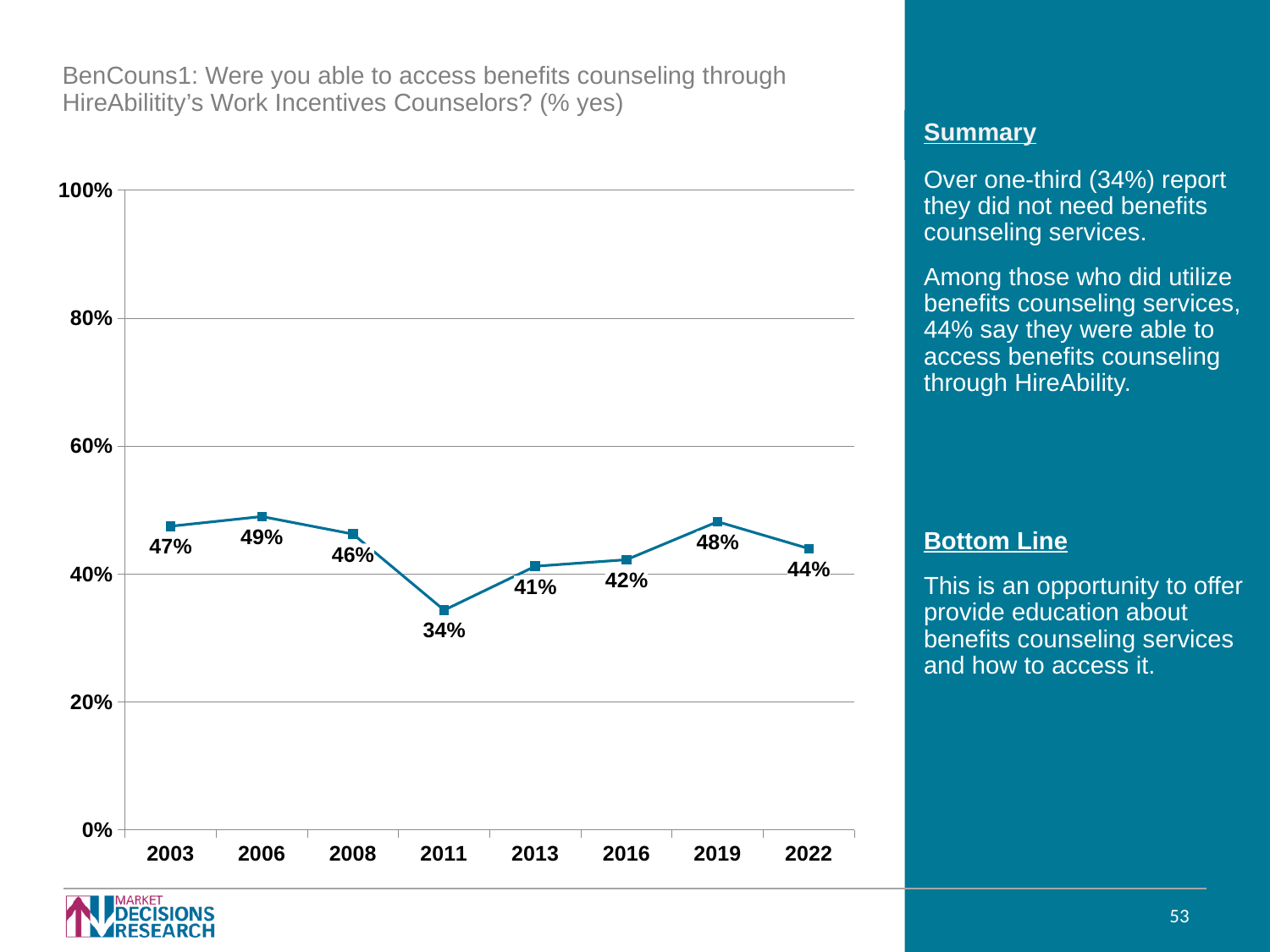
Which is larger, the value for 2019 or the value for 2022? 2019 Do the values rise or fall from 2011 to 2019? rise What is the value for 2003? 47% What is the value for 2022? 44% What is the highest value shown on the y axis? 100% What is the value for 2011? 34% What kind of chart is shown? line chart Which year has the highest value? 2006 Which year has the lowest value? 2011 What is the difference between the values for 2006 and 2011? 15% How many years are plotted on the chart? 8 Is the value for 2011 greater or less than 40%? less